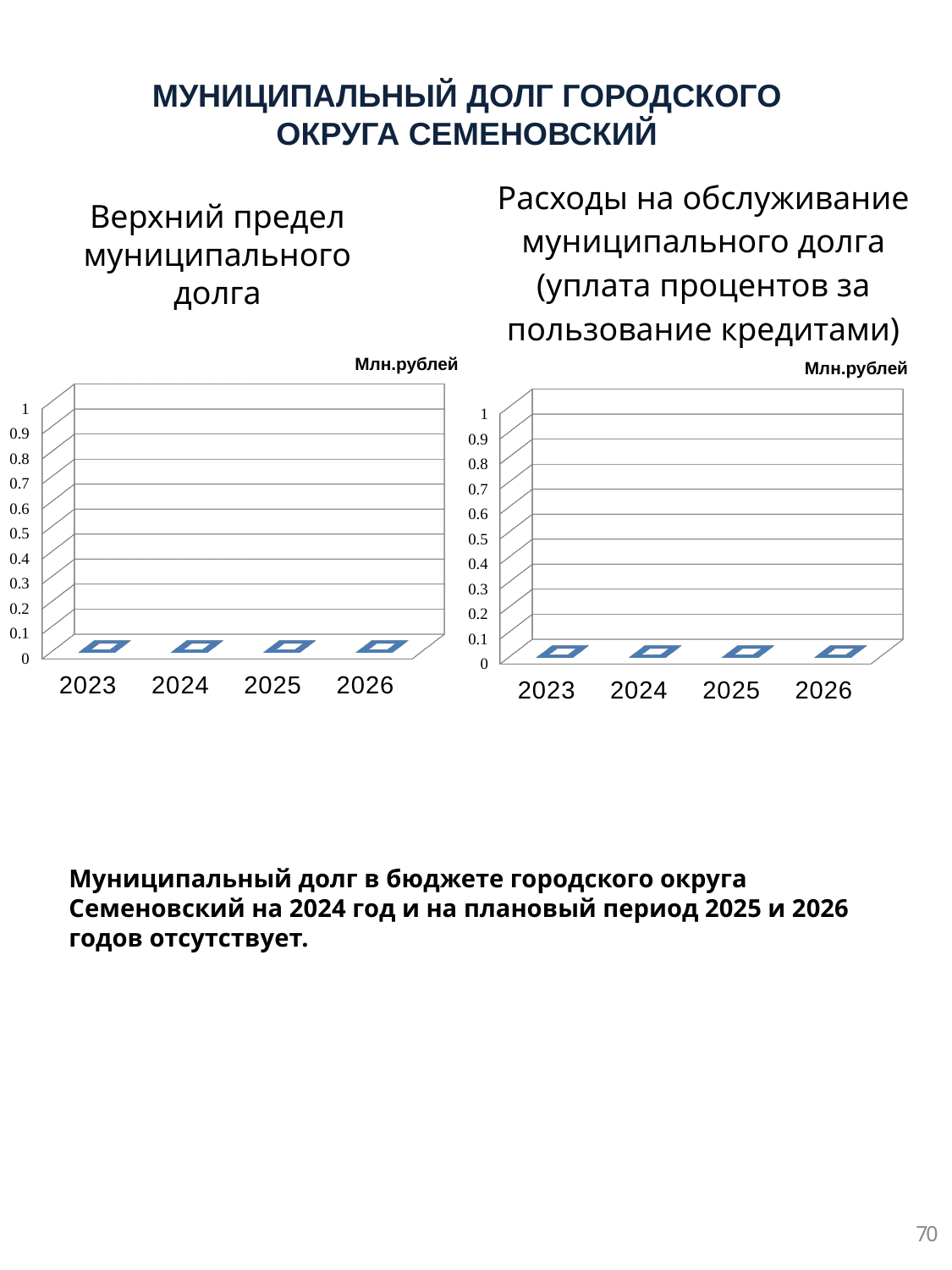
In the right chart "Расходы на обслуживание муниципального долга", what is the value for 2026? 0 In the left chart "Верхний предел муниципального долга", how many years are shown on the x axis? 4 What unit is indicated above the left chart "Верхний предел муниципального долга"? Млн.рублей In the right chart "Расходы на обслуживание муниципального долга", is the value for 2023 greater or less than 0.1? less In the left chart "Верхний предел муниципального долга", is the value for 2025 greater or less than 0.5? less What kind of chart is the left chart titled "Верхний предел муниципального долга"? bar chart In the left chart "Верхний предел муниципального долга", do the values rise, fall or stay the same from 2023 to 2026? stay the same What kind of chart is the right chart titled "Расходы на обслуживание муниципального долга (уплата процентов за пользование кредитами)"? bar chart In the left chart "Верхний предел муниципального долга", which year is the first category on the x axis? 2023 In the right chart "Расходы на обслуживание муниципального долга", what is the highest value shown on the y axis? 1 In the right chart "Расходы на обслуживание муниципального долга", how many categories are shown on the x axis? 4 In the left chart "Верхний предел муниципального долга", what is the value for 2024? 0